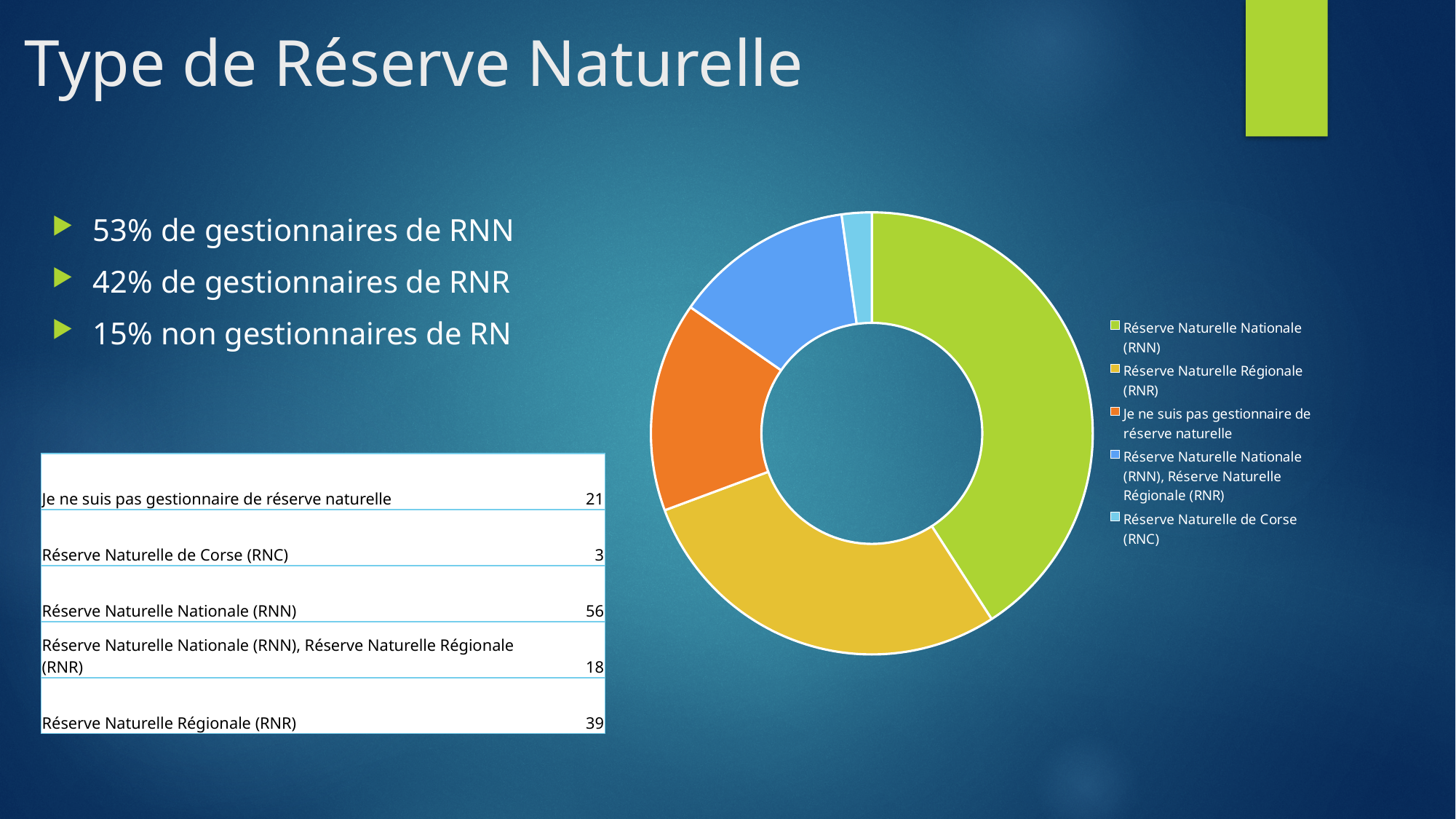
What colour is the slice for Je ne suis pas gestionnaire de réserve naturelle? orange Which category has the largest slice in the doughnut chart? Réserve Naturelle Nationale (RNN) What is the value for Réserve Naturelle Nationale (RNN)? 56 Which category has the smallest slice in the doughnut chart? Réserve Naturelle de Corse (RNC) What is the value for Je ne suis pas gestionnaire de réserve naturelle? 21 Which is larger: the value for Je ne suis pas gestionnaire de réserve naturelle or the value for Réserve Naturelle Nationale (RNN), Réserve Naturelle Régionale (RNR)? Je ne suis pas gestionnaire de réserve naturelle How many slices does the doughnut chart have? 5 What is the value for Réserve Naturelle Régionale (RNR)? 39 What type of chart is shown on the slide? doughnut chart What is the value for Réserve Naturelle de Corse (RNC)? 3 How many entries does the chart legend list? 5 What is the difference between the values for Réserve Naturelle Nationale (RNN) and Réserve Naturelle Régionale (RNR)? 17